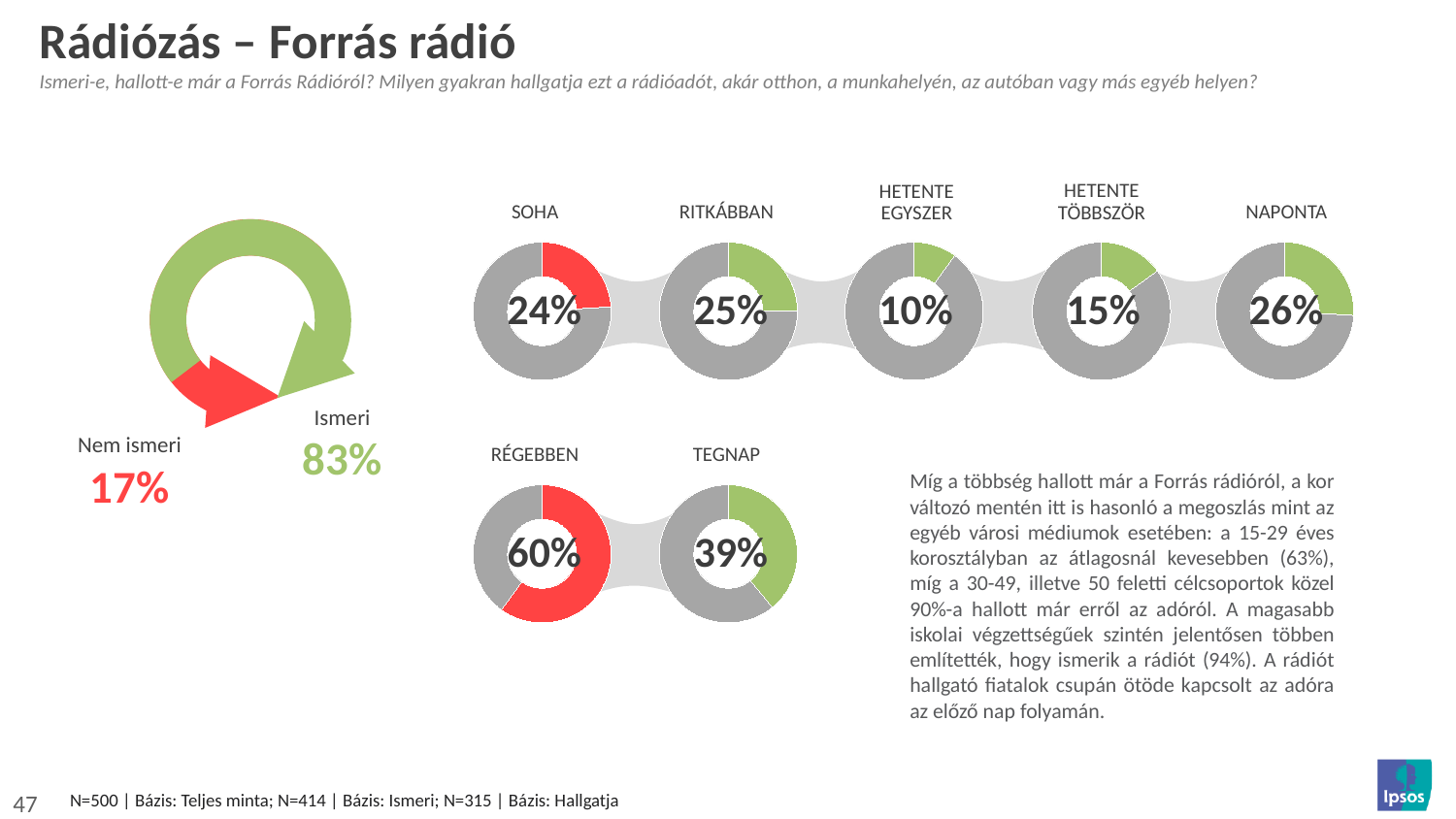
In the row of five small donut charts at the top, which category has the lowest value? HETENTE EGYSZER In the large donut chart on the left, what percentage is shown for "Ismeri"? 83% What type of chart is used to show the "Ismeri" and "Nem ismeri" values on the left? Donut (pie) chart In the large donut chart on the left, what percentage is shown for "Nem ismeri"? 17% In the row of five small donut charts at the top, what is the difference between the values for NAPONTA and HETENTE TÖBBSZÖR? 11% In the pair of small donut charts at the bottom, what value is shown for RÉGEBBEN? 60% In the row of five small donut charts at the top, how many categories are shown? 5 In the row of five small donut charts at the top, what value is shown for HETENTE EGYSZER? 10% In the pair of small donut charts at the bottom, what is the difference between RÉGEBBEN and TEGNAP? 21% In the row of five small donut charts at the top, which category has the highest value? NAPONTA In the pair of small donut charts at the bottom, which is larger: RÉGEBBEN or TEGNAP? RÉGEBBEN In the row of five small donut charts at the top, what value is shown for SOHA? 24%